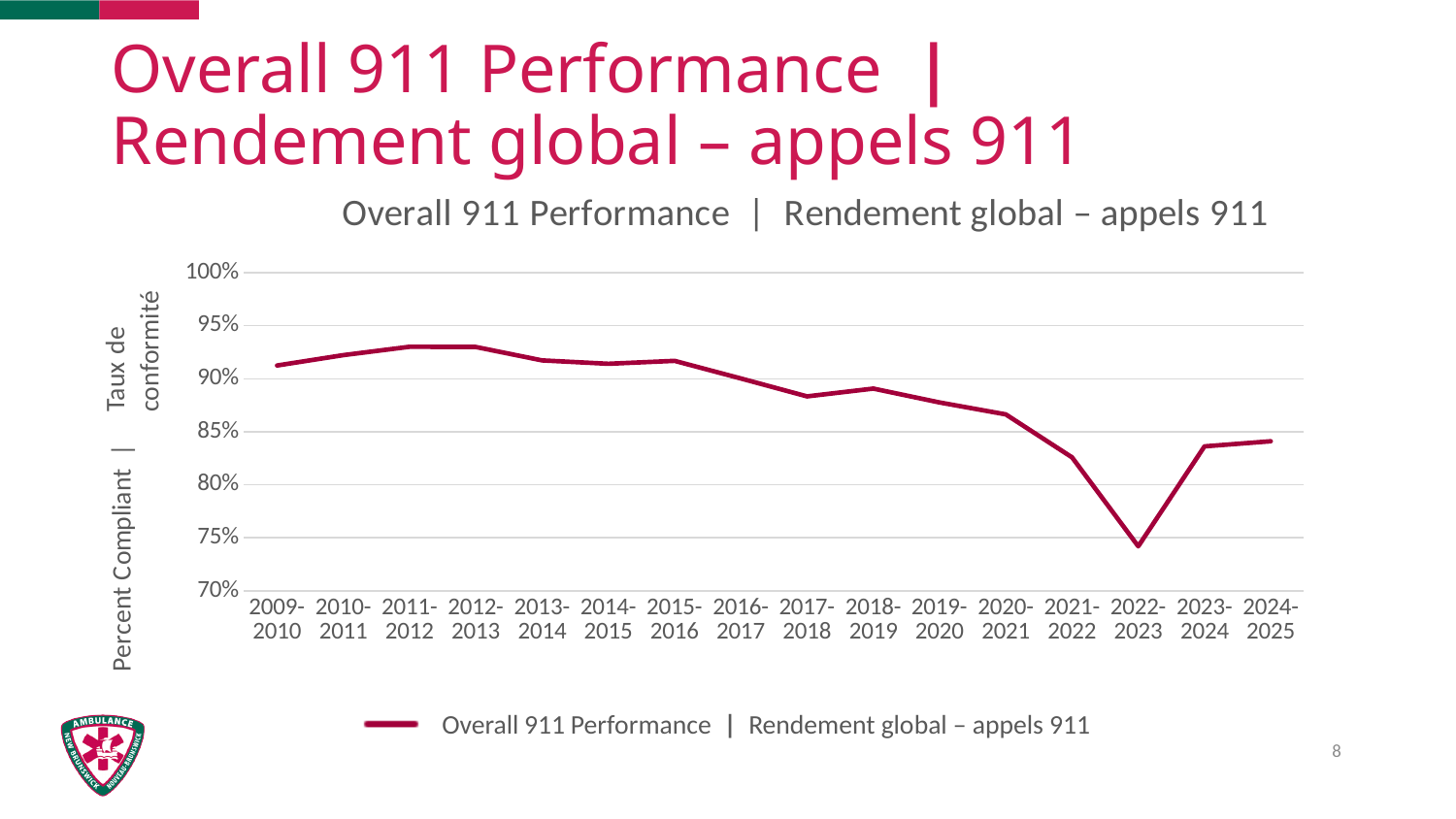
How many fiscal years are plotted along the x axis? 16 What kind of chart is shown on the slide? Line chart How many series does the legend list? 1 Which is higher, the value for 2020-2021 or the value for 2024-2025? 2020-2021 What is the label on the y axis? Percent Compliant | Taux de conformité Which is higher, the value for 2012-2013 or the value for 2019-2020? 2012-2013 Is the value for 2022-2023 greater or less than 75%? less Is the value for 2021-2022 greater or less than 85%? less Is the value for 2017-2018 greater or less than 90%? less Which fiscal year has the lowest percent compliant? 2022-2023 Does the line generally rise or fall from 2012-2013 to 2022-2023? Fall